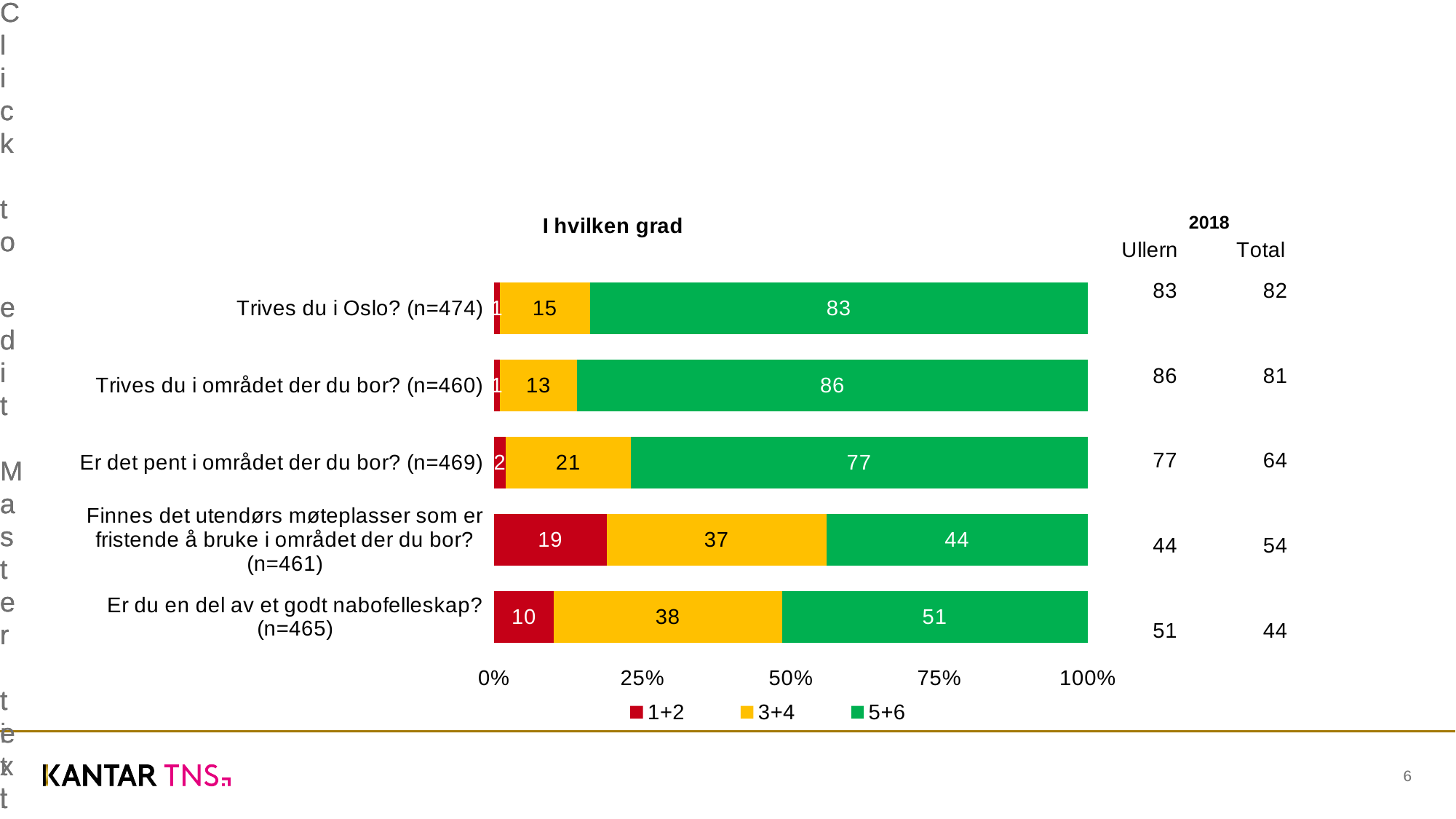
What is the value of the 3+4 series for "Er du en del av et godt nabofelleskap? (n=465)"? 38 What is the title of the chart? I hvilken grad What is the value of the 1+2 series for "Finnes det utendørs møteplasser som er fristende å bruke i området der du bor? (n=461)"? 19 How many categories (questions) are shown in the chart? 5 What is the value of the 5+6 series for "Trives du i Oslo? (n=474)"? 83 Which category has the lowest value for the 5+6 series? Finnes det utendørs møteplasser som er fristende å bruke i området der du bor? (n=461) How many series does the legend list? 3 Which category has the highest value for the 5+6 series? Trives du i området der du bor? (n=460) Which is larger: the 3+4 value for "Er du en del av et godt nabofelleskap? (n=465)" or the 3+4 value for "Er det pent i området der du bor? (n=469)"? Er du en del av et godt nabofelleskap? (n=465) What is the total of the stacked bar for "Er du en del av et godt nabofelleskap? (n=465)"? 99 What is the difference between the 5+6 values for "Trives du i området der du bor? (n=460)" and "Er det pent i området der du bor? (n=469)"? 9 What kind of chart is shown on the slide? Stacked bar chart